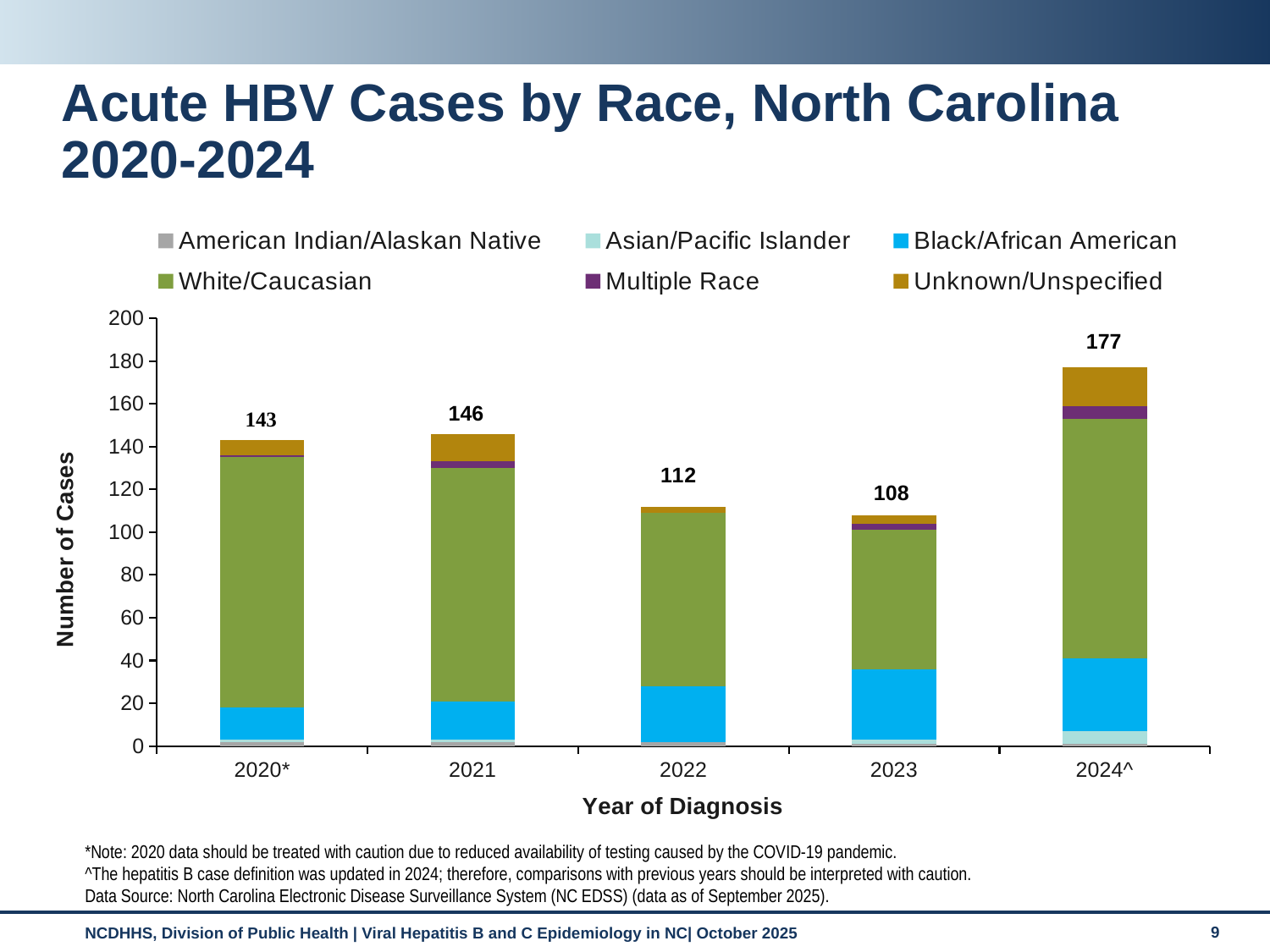
What is the label on the y axis of the chart? Number of Cases Is the Black/African American segment for 2022 greater or less than 20 cases? greater How many years of diagnosis are shown on the x axis? 5 What kind of chart is shown on the slide? Stacked bar chart What is the difference between the total cases in 2024^ and the total cases in 2023? 69 Which year of diagnosis has the highest total number of cases? 2024^ Which year of diagnosis has the lowest total number of cases? 2023 What is the total number of cases shown for 2022? 112 What is the total number of acute HBV cases shown for 2024^? 177 Which year has a larger total number of cases, 2020* or 2021? 2021 Did the total number of cases rise or fall from 2023 to 2024^? Rise How many race categories does the legend list? 6